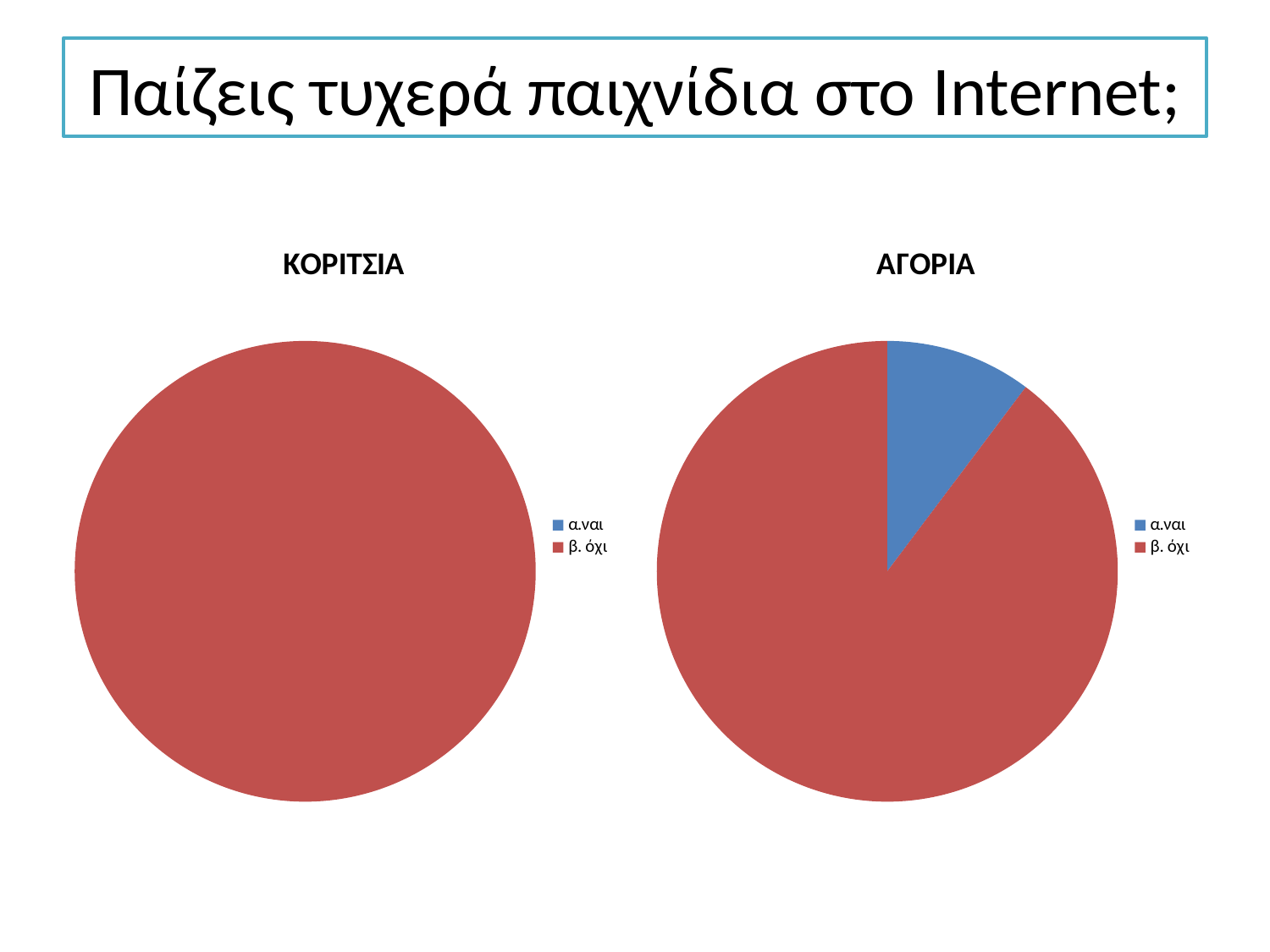
In the ΑΓΟΡΙΑ chart, which category has the smallest slice? α.ναι What is the title of the chart on the left? ΚΟΡΙΤΣΙΑ In the ΚΟΡΙΤΣΙΑ chart, which category has the largest slice? β. όχι What kind of chart is the ΚΟΡΙΤΣΙΑ chart? pie chart How many entries does the legend of the ΑΓΟΡΙΑ chart list? 2 In the ΑΓΟΡΙΑ chart, which category has the largest slice? β. όχι In the ΑΓΟΡΙΑ chart, which is larger: the slice for α.ναι or the slice for β. όχι? β. όχι What kind of chart is the ΑΓΟΡΙΑ chart? pie chart How many entries does the legend of the ΚΟΡΙΤΣΙΑ chart list? 2 How many charts are shown on the slide? 2 In the ΑΓΟΡΙΑ chart, what colour is the slice for α.ναι? blue